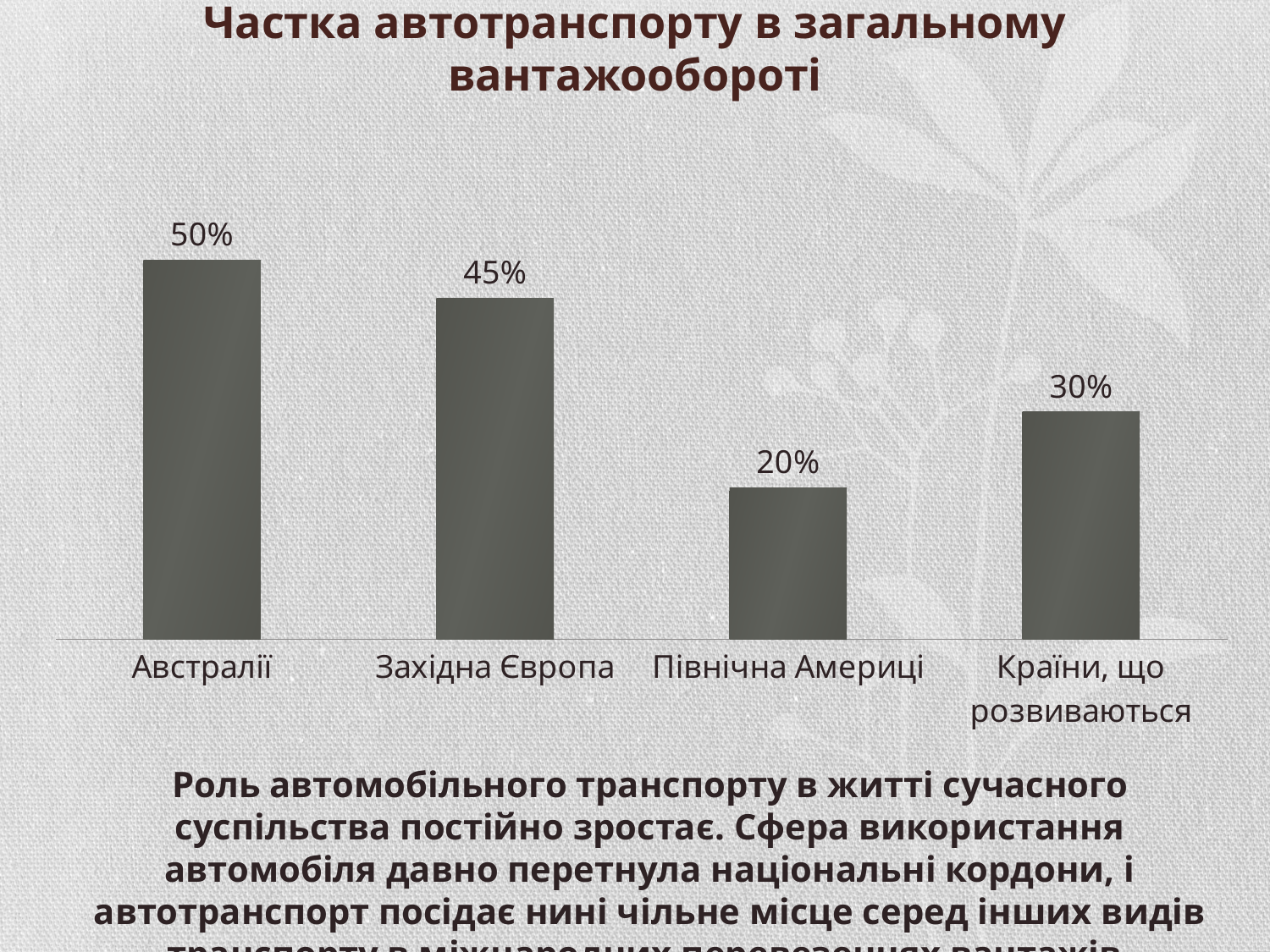
How many categories are shown in the chart? 4 What is the value for Країни, що розвиваються? 30% What kind of chart is shown on the slide? Bar chart What is the value for Західна Європа? 45% Which category has the highest value? Австралії What is the difference between the values for Австралії and Північна Америці? 30% Which category has the lowest value? Північна Америці What is the value for Австралії? 50% Which is larger, the value for Західна Європа or the value for Країни, що розвиваються? Західна Європа What is the difference between the values for Західна Європа and Країни, що розвиваються? 15% What is the title of the chart? Частка автотранспорту в загальному вантажообороті What is the value for Північна Америці? 20%